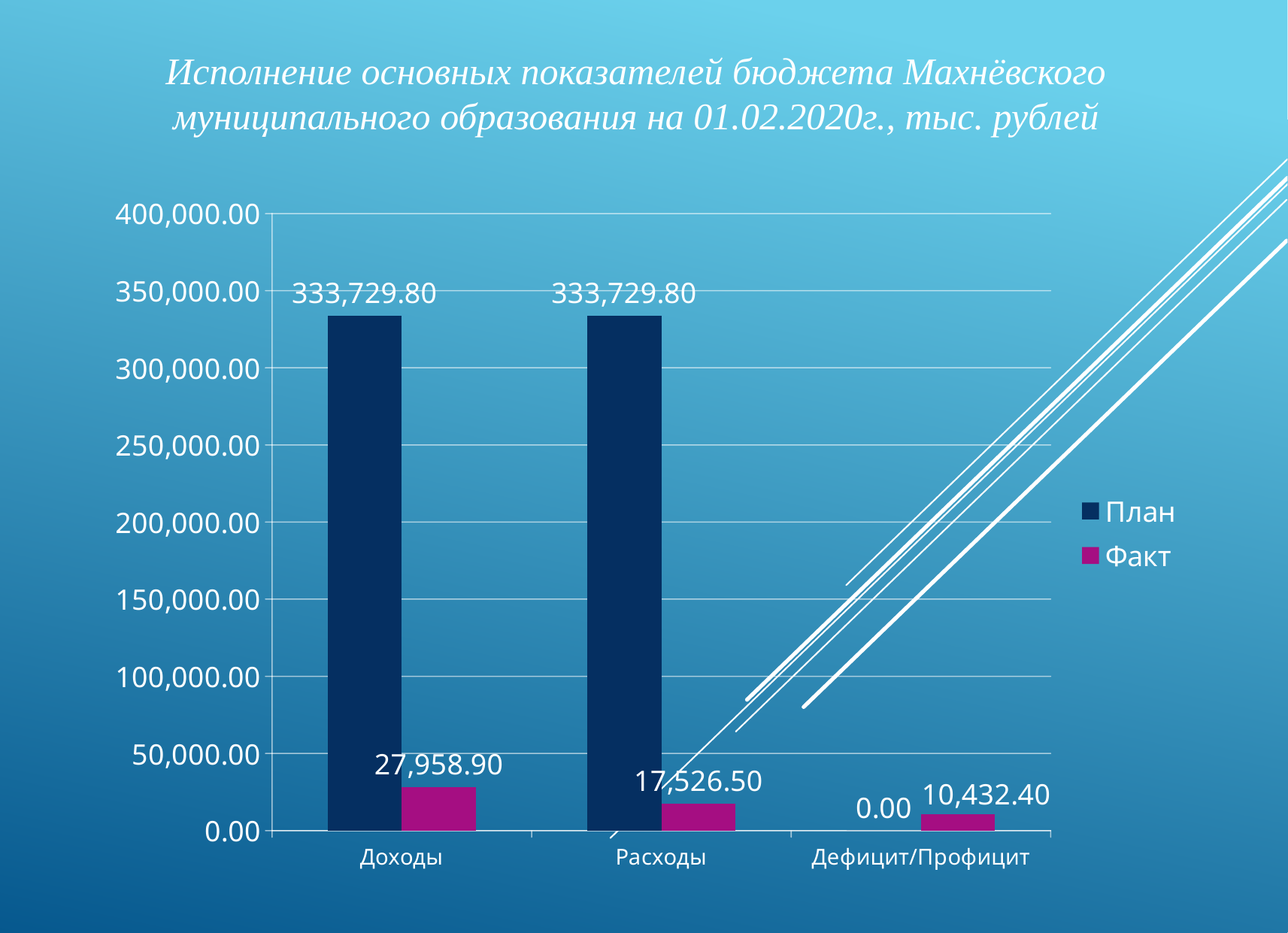
How many series does the legend list? 2 How many categories are shown on the x axis? 3 Which is larger: the Факт value for Расходы or the Факт value for Дефицит/Профицит? Расходы Which category has the lowest Факт value? Дефицит/Профицит What is the Факт value for Дефицит/Профицит? 10,432.40 What is the План value for Доходы? 333,729.80 What is the Факт value for Доходы? 27,958.90 What is the План value for Дефицит/Профицит? 0.00 Which category has the highest Факт value? Доходы What is the difference between the Факт values for Доходы and Расходы? 10,432.40 What is the Факт value for Расходы? 17,526.50 What kind of chart is shown on the slide? Bar chart